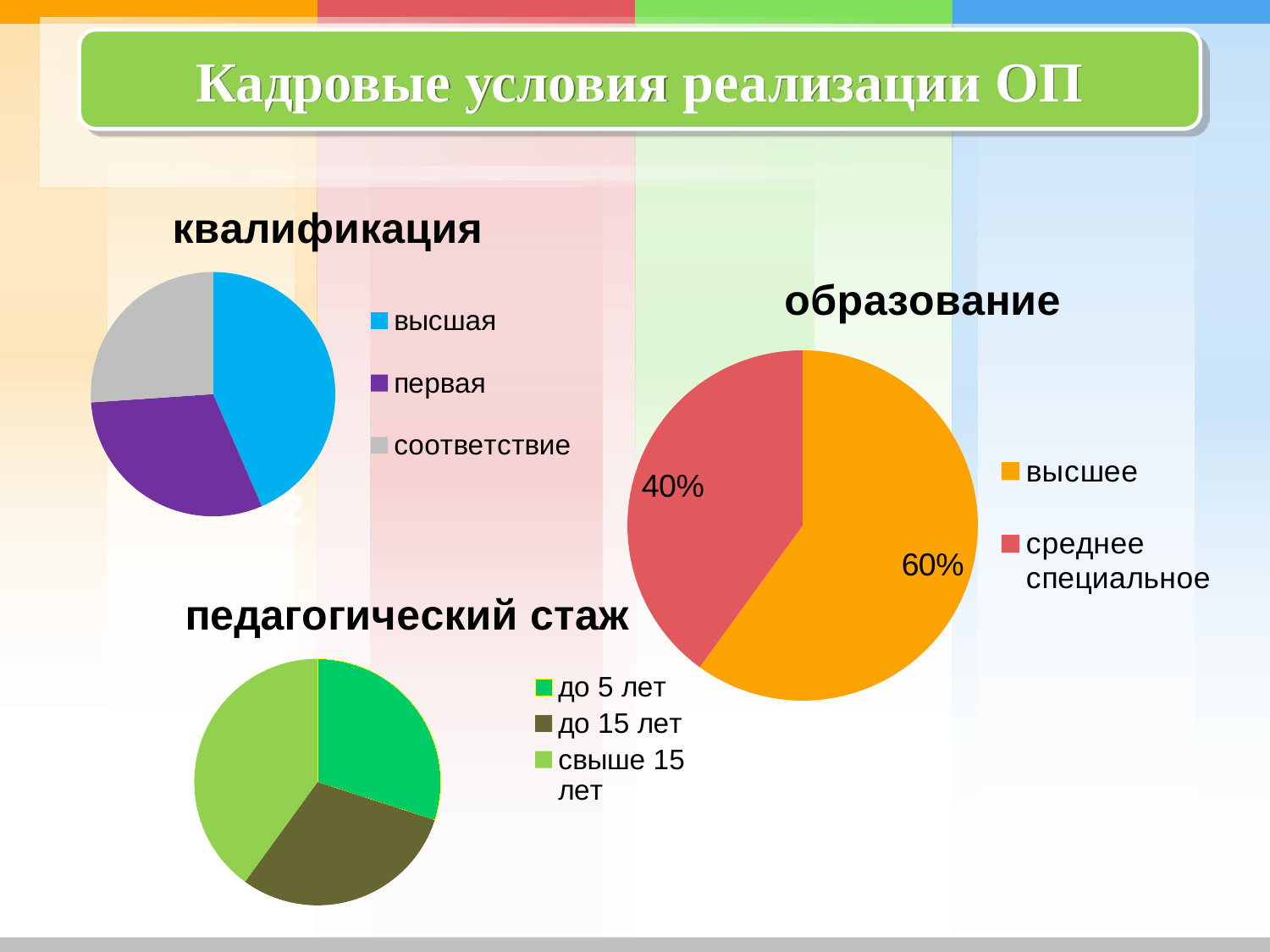
How many categories does the 'квалификация' pie chart have? 3 In the 'образование' pie chart, which category has the smallest share? среднее специальное In the 'образование' pie chart, which category has the largest share? высшее In the 'квалификация' pie chart, what colour represents 'соответствие'? grey In the 'образование' pie chart, which is larger: 'высшее' or 'среднее специальное'? высшее In the 'образование' pie chart, what percentage is shown for 'среднее специальное'? 40% In the 'образование' pie chart, what percentage is shown for 'высшее'? 60% In the 'квалификация' pie chart, which category has the largest slice? высшая What type of chart is used for 'образование'? pie chart In the 'педагогический стаж' pie chart, which category has the largest slice? свыше 15 лет How many entries does the legend of the 'педагогический стаж' chart list? 3 In the 'образование' pie chart, what is the difference in percentage points between 'высшее' and 'среднее специальное'? 20